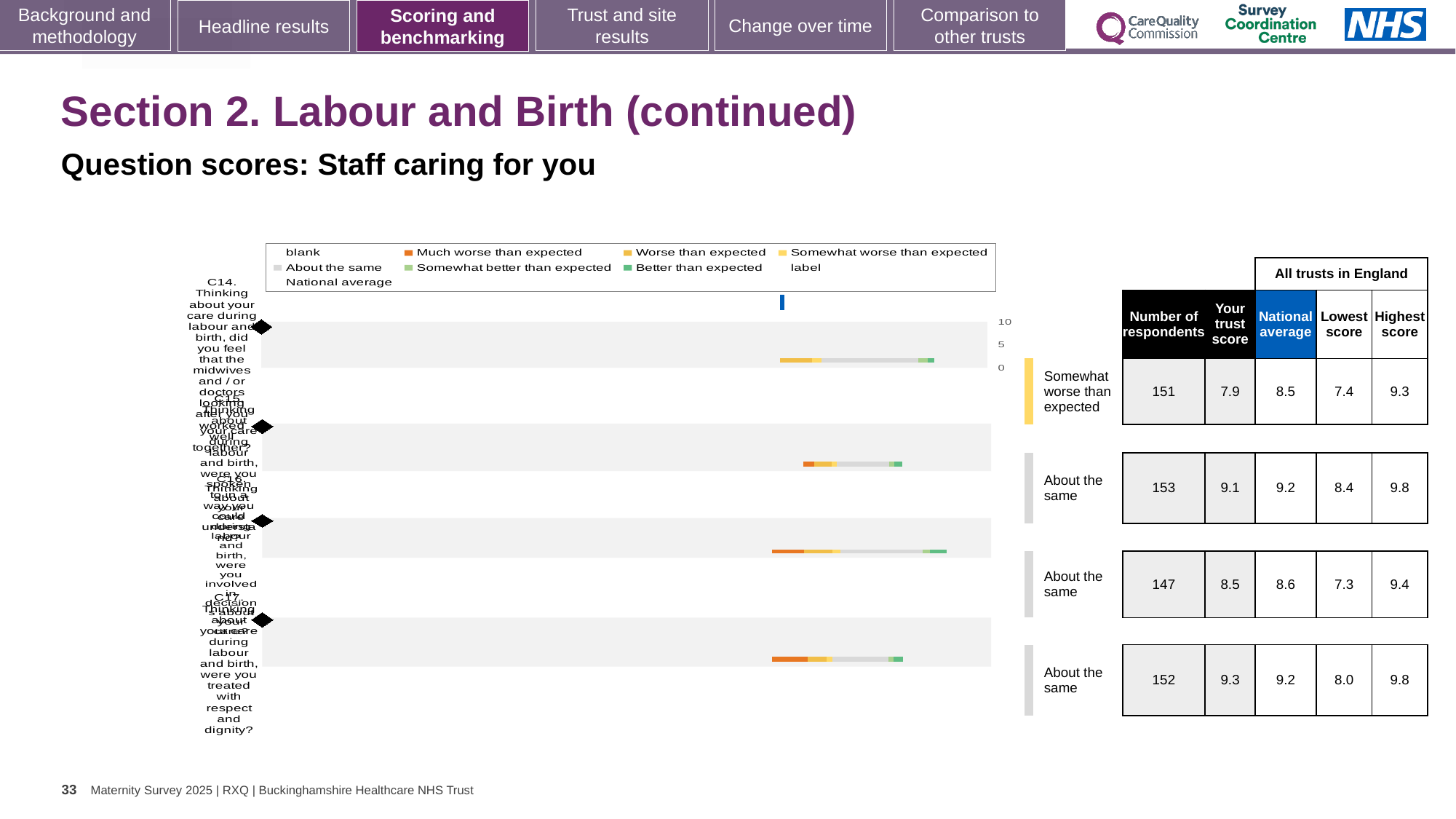
How many entries does the chart legend list? 9 In the table beside the chart, what is the national average for the first row (C14)? 8.5 What kind of chart is shown on the slide? bar chart What benchmark category is given for the first row (C14) in the table? Somewhat worse than expected In the table beside the chart, which row has the lowest number of respondents? the third row (C16), 147 In the table beside the chart, what is the number of respondents for the last row (C17)? 152 In the table, is the 'Your trust score' for the second row (9.1) larger or smaller than its national average (9.2)? smaller What is the difference between the highest 'Your trust score' (9.3) and the lowest 'Your trust score' (7.9) in the table? 1.4 How many question rows (categories) does the chart plot? 4 In the table beside the chart, what is the 'Your trust score' for the first row (C14)? 7.9 In the table beside the chart, which row has the highest 'Your trust score'? the last row (C17), 9.3 What is the highest tick value shown on the chart's axis? 10